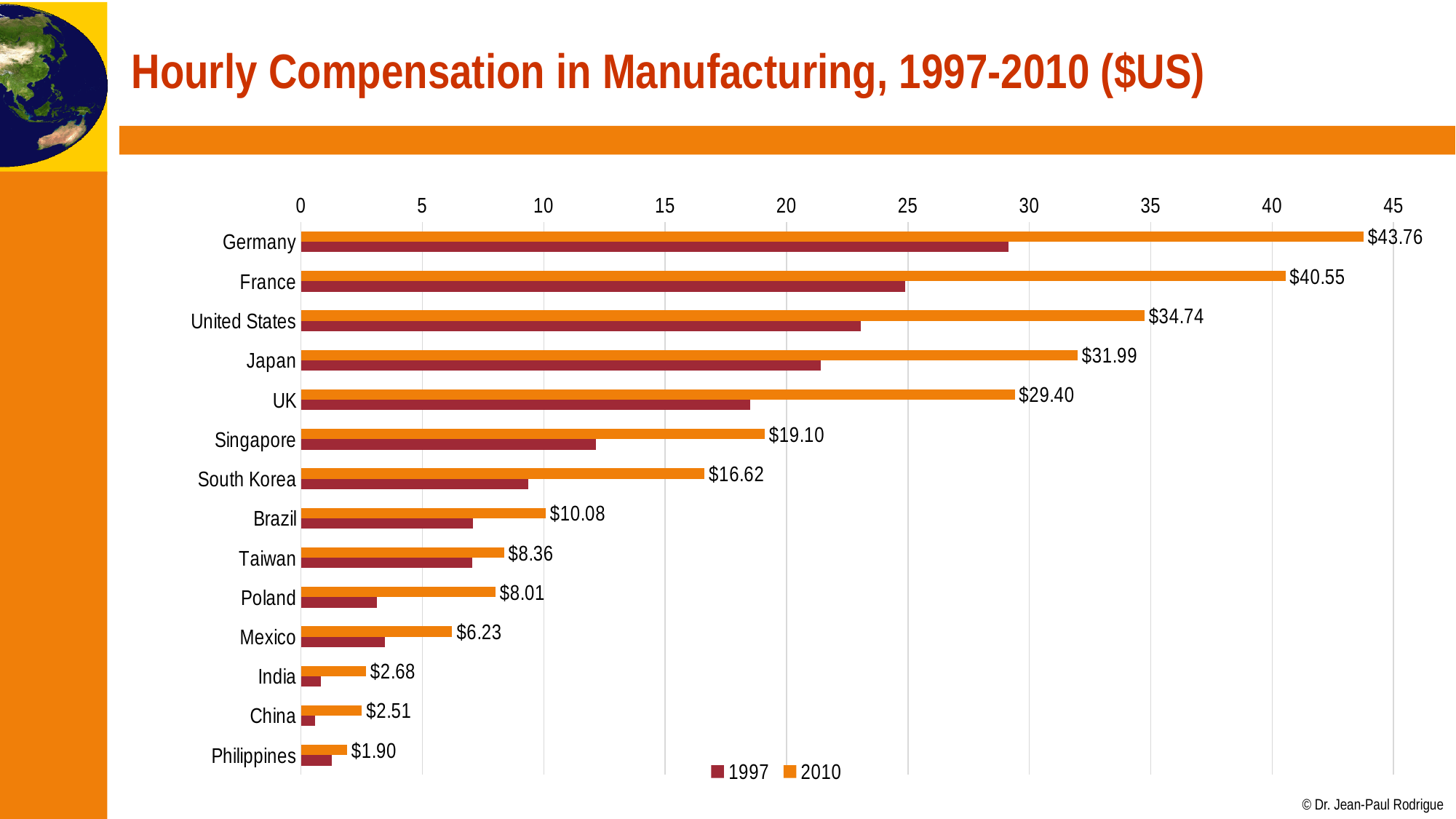
Which country had the highest hourly compensation in 2010? Germany What was the hourly compensation in manufacturing for South Korea in 2010? $16.62 Is the 1997 value for Japan greater or less than 25? less Is the 1997 value for Germany greater or less than 25? greater Which country had the lowest hourly compensation in 2010? Philippines How many countries are shown in the chart? 14 Which had the higher hourly compensation in 2010, Taiwan or Poland? Taiwan What was the hourly compensation in manufacturing for Germany in 2010? $43.76 What kind of chart is shown on the slide? Bar chart How many series does the legend list? 2 Is the 1997 value for Poland greater or less than 5? less What is the difference between Germany's and France's 2010 hourly compensation? $3.21